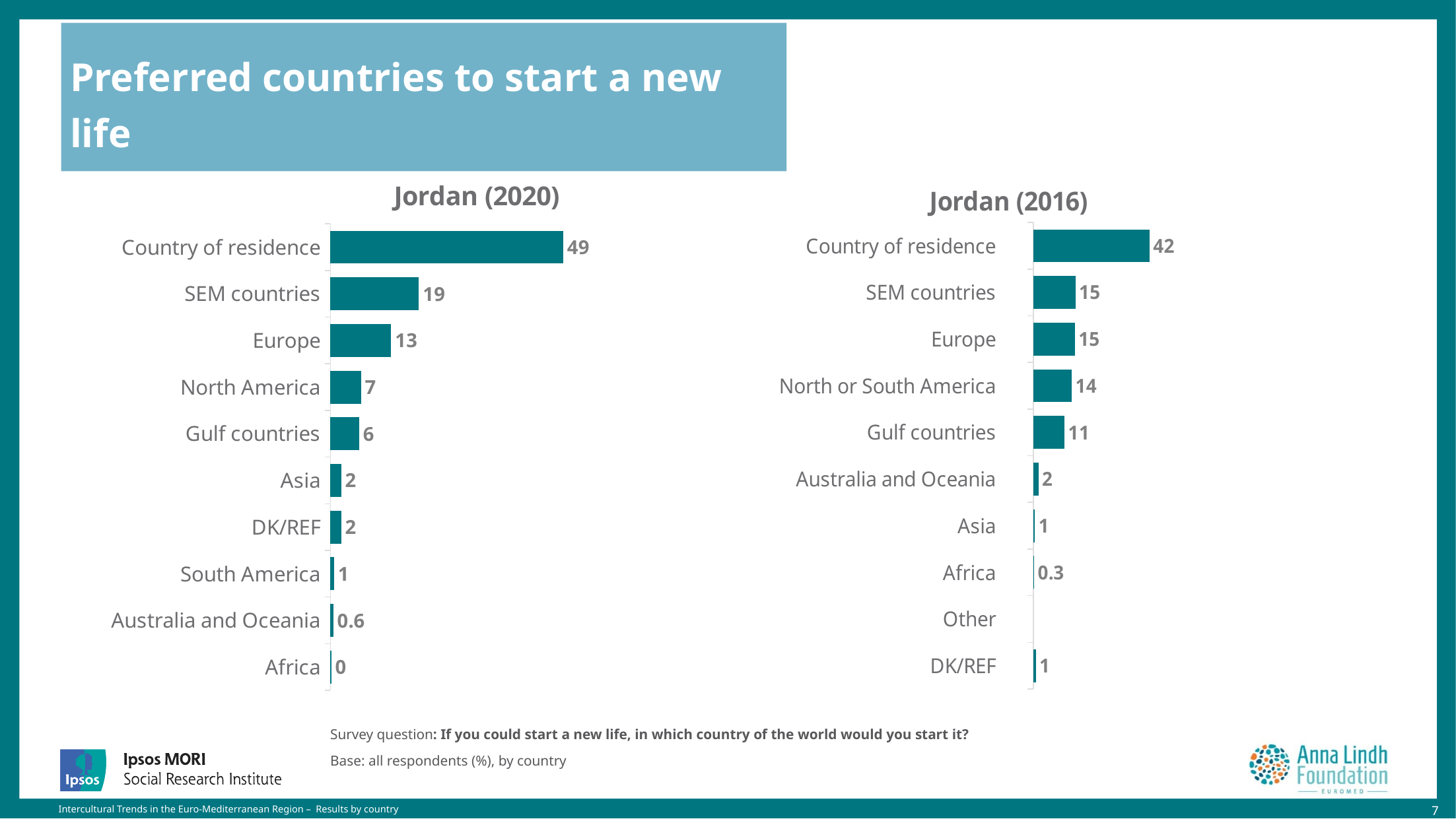
How many categories are shown in the Jordan (2016) chart? 10 In the Jordan (2016) chart, what is the value for Gulf countries? 11 In the Jordan (2016) chart, what is the difference between Country of residence and SEM countries? 27 In the Jordan (2016) chart, what is the value for Africa? 0.3 In the Jordan (2020) chart, what is the difference between SEM countries and Europe? 6 Which is larger: Gulf countries in the Jordan (2020) chart or Gulf countries in the Jordan (2016) chart? Jordan (2016) What type of chart is the Jordan (2020) chart? Bar chart In the Jordan (2020) chart, what is the value for Australia and Oceania? 0.6 In the Jordan (2020) chart, which category has the highest value? Country of residence What is the title of the chart on the right side of the slide? Jordan (2016) In the Jordan (2020) chart, which category has the lowest value? Africa In the Jordan (2020) chart, what is the value for Country of residence? 49